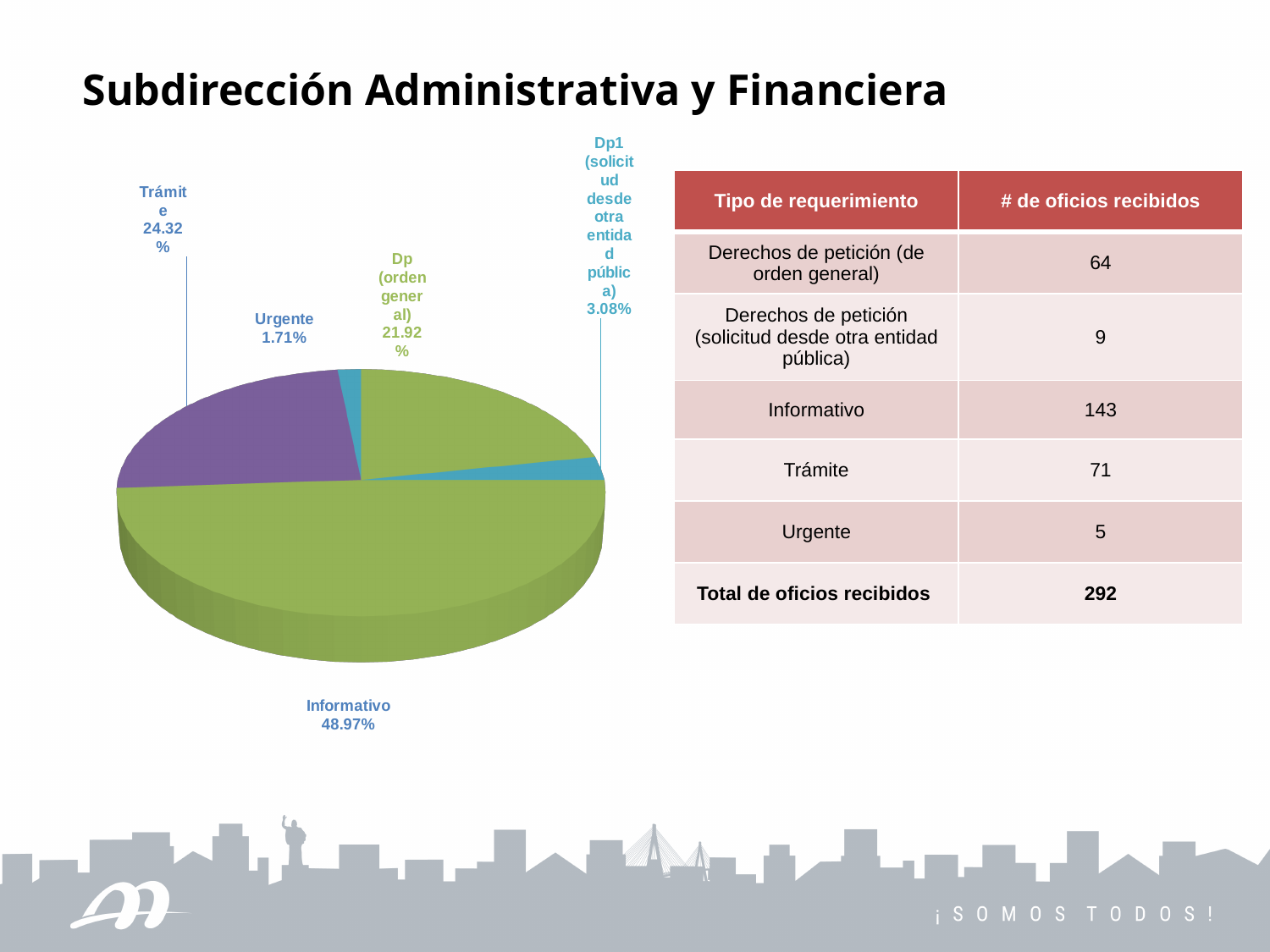
Which slice is larger in the pie chart, Trámite or Dp (orden general)? Trámite What percentage does the pie chart show for Dp (orden general)? 21.92% What kind of chart is shown on the slide? pie chart What percentage does the pie chart show for Dp1 (solicitud desde otra entidad pública)? 3.08% What percentage does the pie chart show for Informativo? 48.97% What is the difference in percentage points between the Informativo slice and the Trámite slice? 24.65 How many slices does the pie chart have? 5 What is the combined share of the Urgente and Dp1 (solicitud desde otra entidad pública) slices? 4.79% What percentage does the pie chart show for Trámite? 24.32% Which category has the largest slice in the pie chart? Informativo What percentage does the pie chart show for Urgente? 1.71% Which category has the smallest slice in the pie chart? Urgente